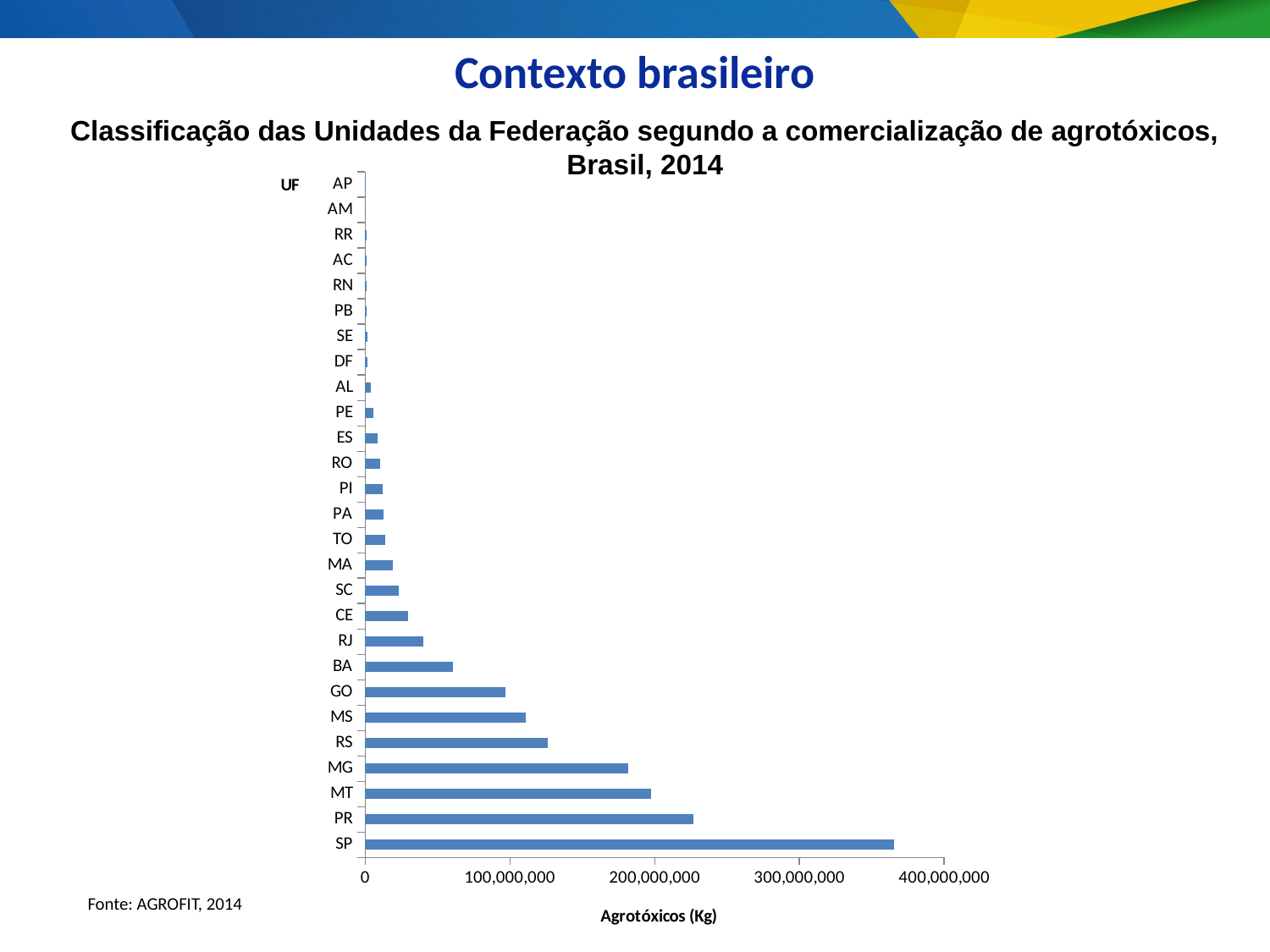
What source is cited for the chart data? AGROFIT, 2014 Is the value for RS greater or less than 100,000,000? greater Is the value for PR greater or less than 200,000,000? greater Which has a larger value, MG or RS? MG Which has a larger value, SP or PR? SP Is the value for MG greater or less than 200,000,000? less What kind of chart is shown on the slide? bar chart How many UFs (categories) are plotted in the chart? 27 What is the label of the horizontal axis of the chart? Agrotóxicos (Kg) Which UF has the highest value for agrotóxicos (Kg)? SP